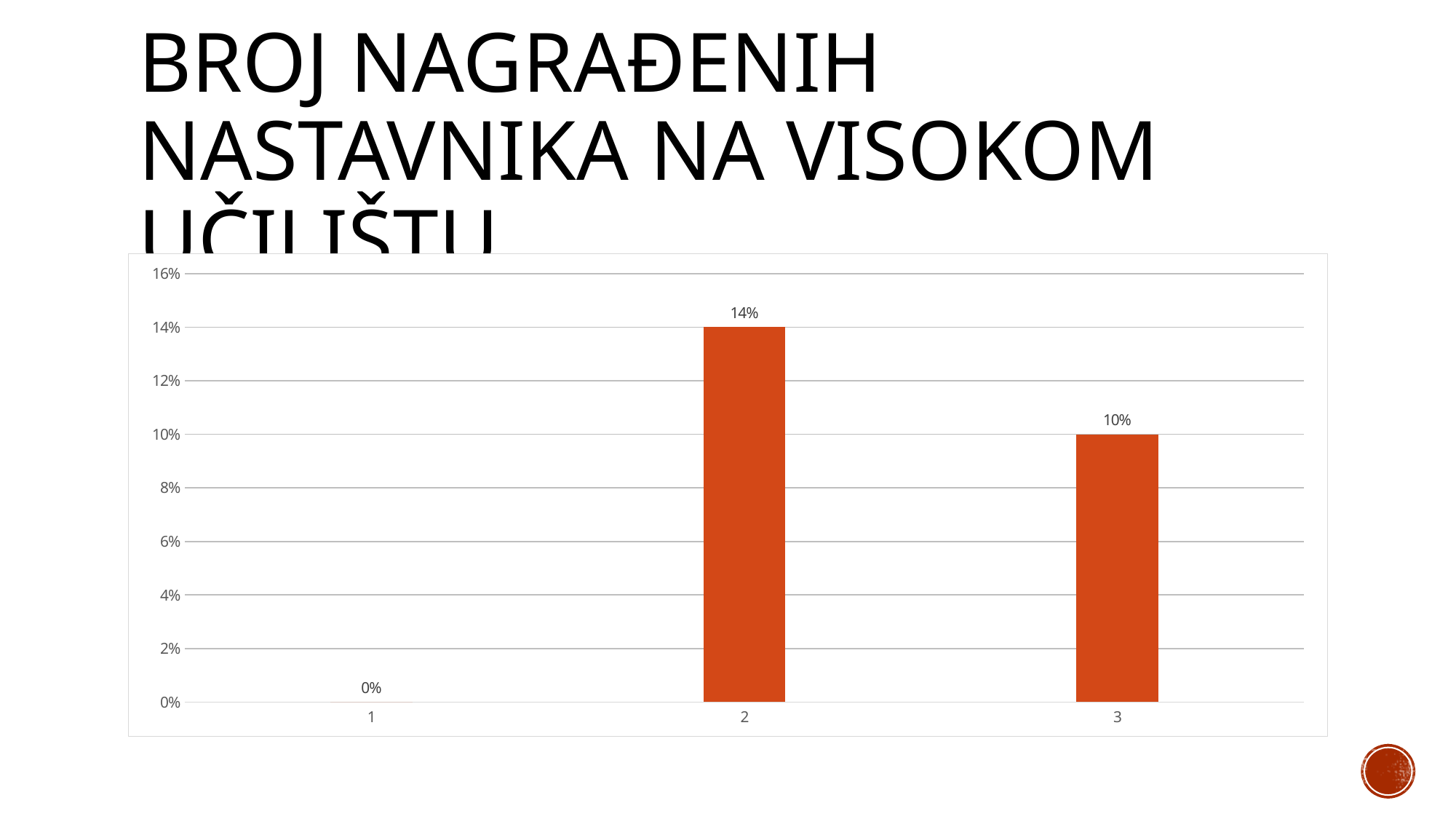
What kind of chart is shown on the slide? bar chart Which category has the lowest value? 1 What is the difference between the values for category 2 and category 3? 4% What is the value for category 1? 0% What is the value for category 2? 14% Is the value for category 3 greater or less than 12%? less Which is larger, the value for category 2 or category 3? 2 Which category has the highest value? 2 How many categories are shown on the x axis? 3 What is the value for category 3? 10% What colour are the bars in the chart? orange What is the highest value shown on the y axis? 16%